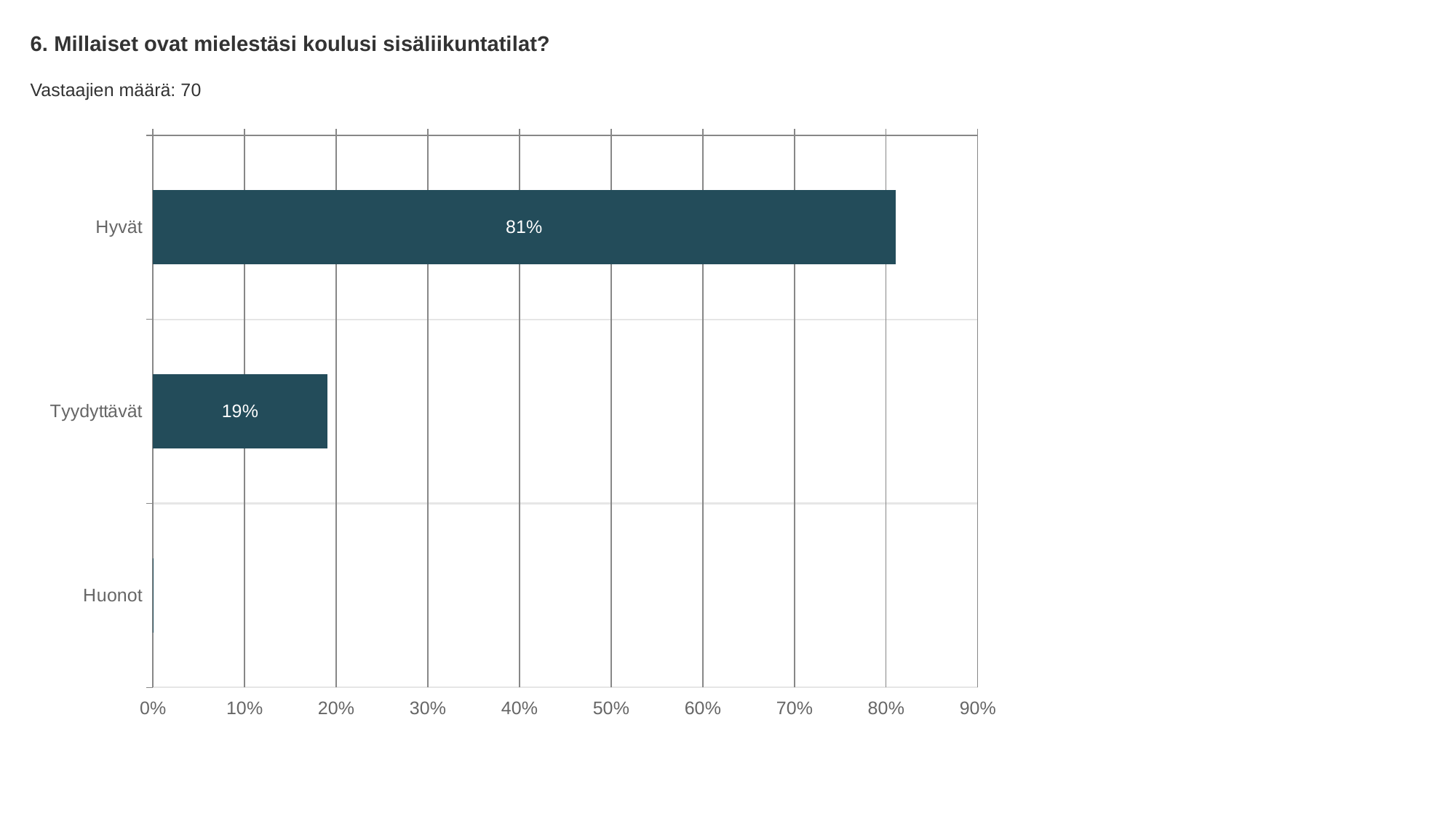
Which category has the lowest value? Huonot How many respondents (Vastaajien määrä) are reported on the slide? 70 What is the title of the chart? 6. Millaiset ovat mielestäsi koulusi sisäliikuntatilat? Is the value for Huonot greater or less than 10%? less What is the value for Hyvät? 81% What is the value for Tyydyttävät? 19% What kind of chart is shown on the slide? bar chart How many categories are shown in the chart? 3 Which is larger, the value for Hyvät or the value for Tyydyttävät? Hyvät What is the difference between the values for Hyvät and Tyydyttävät? 62% Which category has the highest value? Hyvät Is the value for Hyvät greater or less than 70%? greater